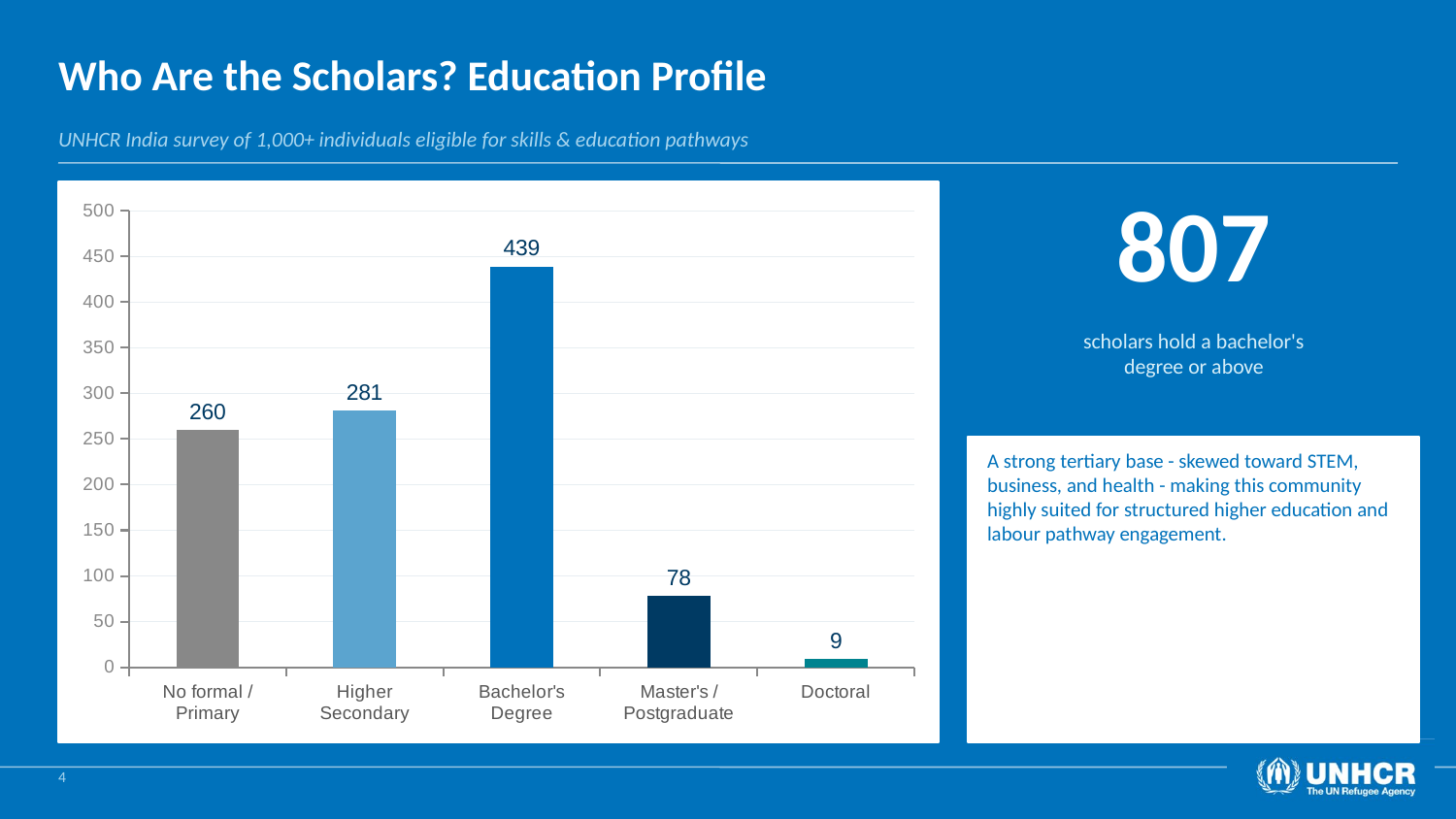
What is the difference between the values for Master's / Postgraduate and Doctoral? 69 How many categories are shown on the x axis? 5 Which category has the highest value? Bachelor's Degree What kind of chart is shown on the slide? bar chart Which category has the lowest value? Doctoral What is the maximum value shown on the y axis? 500 What is the difference between the values for Bachelor's Degree and Higher Secondary? 158 What is the value for Master's / Postgraduate? 78 What is the value for Bachelor's Degree? 439 What is the value for No formal / Primary? 260 Which is larger, the value for Higher Secondary or the value for No formal / Primary? Higher Secondary Is the value for Bachelor's Degree greater or less than 400? greater